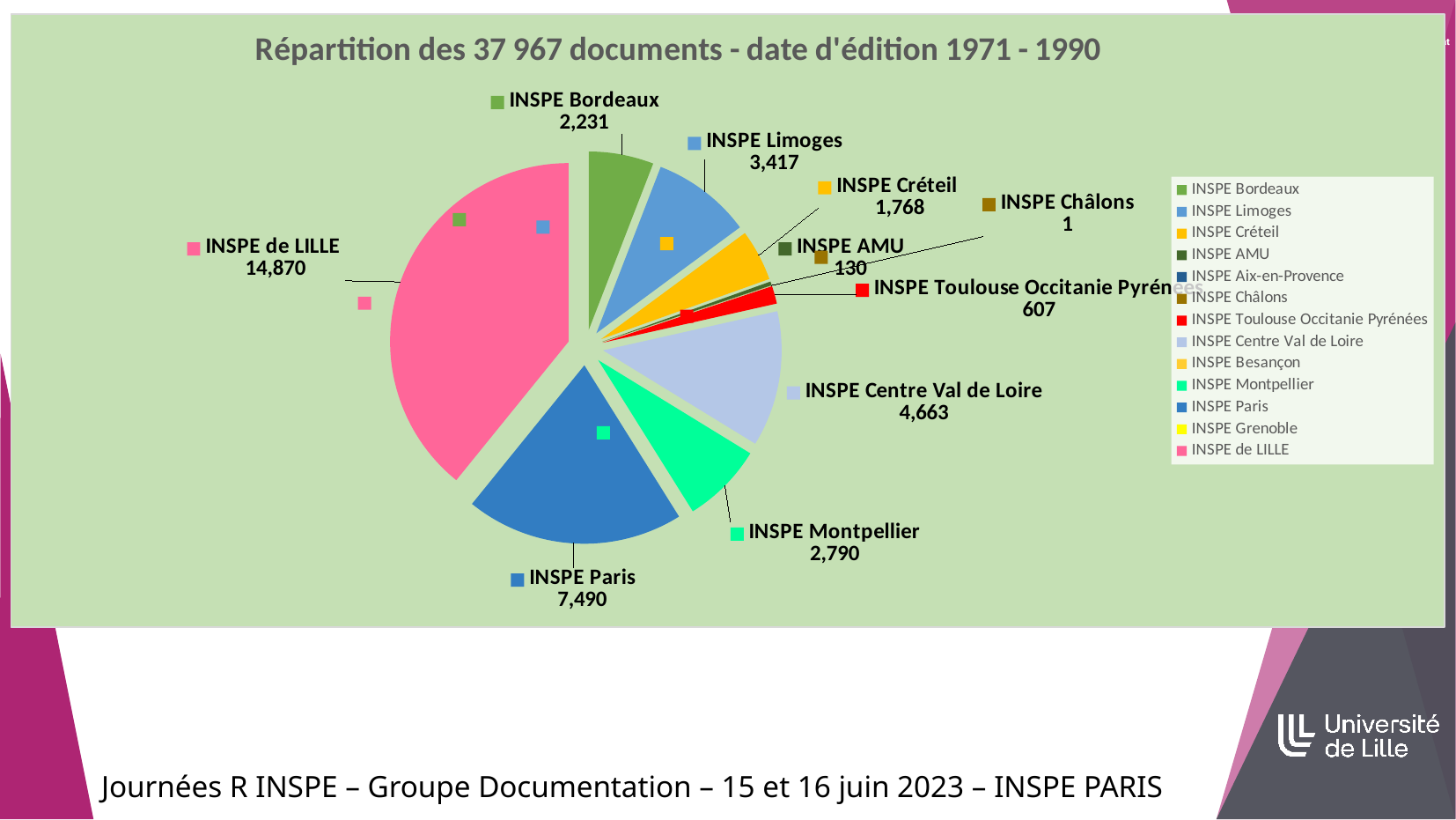
What share of the 37 967 documents does INSPE de LILLE represent? 39.2% Which INSPE has the largest slice of the pie? INSPE de LILLE How many INSPE entries does the legend list? 13 What is the value shown for INSPE Centre Val de Loire? 4,663 What kind of chart is shown on the slide? Pie chart What is the value shown for INSPE Paris? 7,490 How many documents are attributed to INSPE de LILLE? 14,870 What is the value shown for INSPE AMU? 130 What is the difference between the values for INSPE de LILLE and INSPE Paris? 7,380 What is the title of the chart? Répartition des 37 967 documents - date d'édition 1971 - 1990 Which has a larger value, INSPE Limoges or INSPE Montpellier? INSPE Limoges Which labelled INSPE has the smallest value? INSPE Châlons